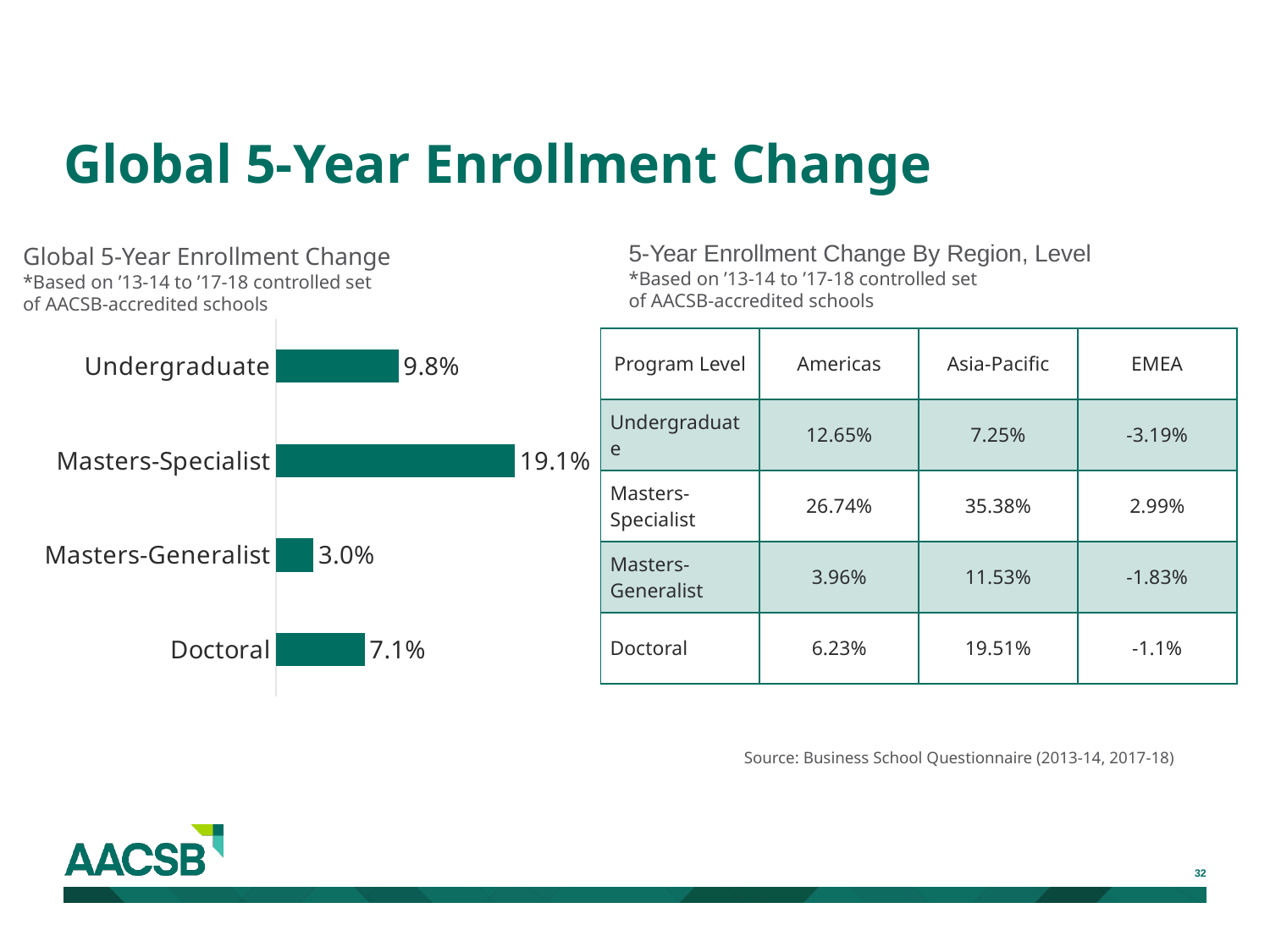
What is the value for Masters-Specialist in the bar chart? 19.1% What is the value for Doctoral in the bar chart? 7.1% What is the difference between the Masters-Specialist and Undergraduate values in the bar chart? 9.3 percentage points What is the title of the bar chart? Global 5-Year Enrollment Change Which program level has the highest value in the bar chart? Masters-Specialist In the bar chart, which is larger: the value for Undergraduate or the value for Doctoral? Undergraduate What is the difference between the Doctoral and Masters-Generalist values in the bar chart? 4.1 percentage points Which program level has the lowest value in the bar chart? Masters-Generalist How many program levels are shown in the bar chart? 4 What is the value for Masters-Generalist in the bar chart? 3.0% What is the value for Undergraduate in the bar chart? 9.8% What type of chart is shown on the slide? Bar chart